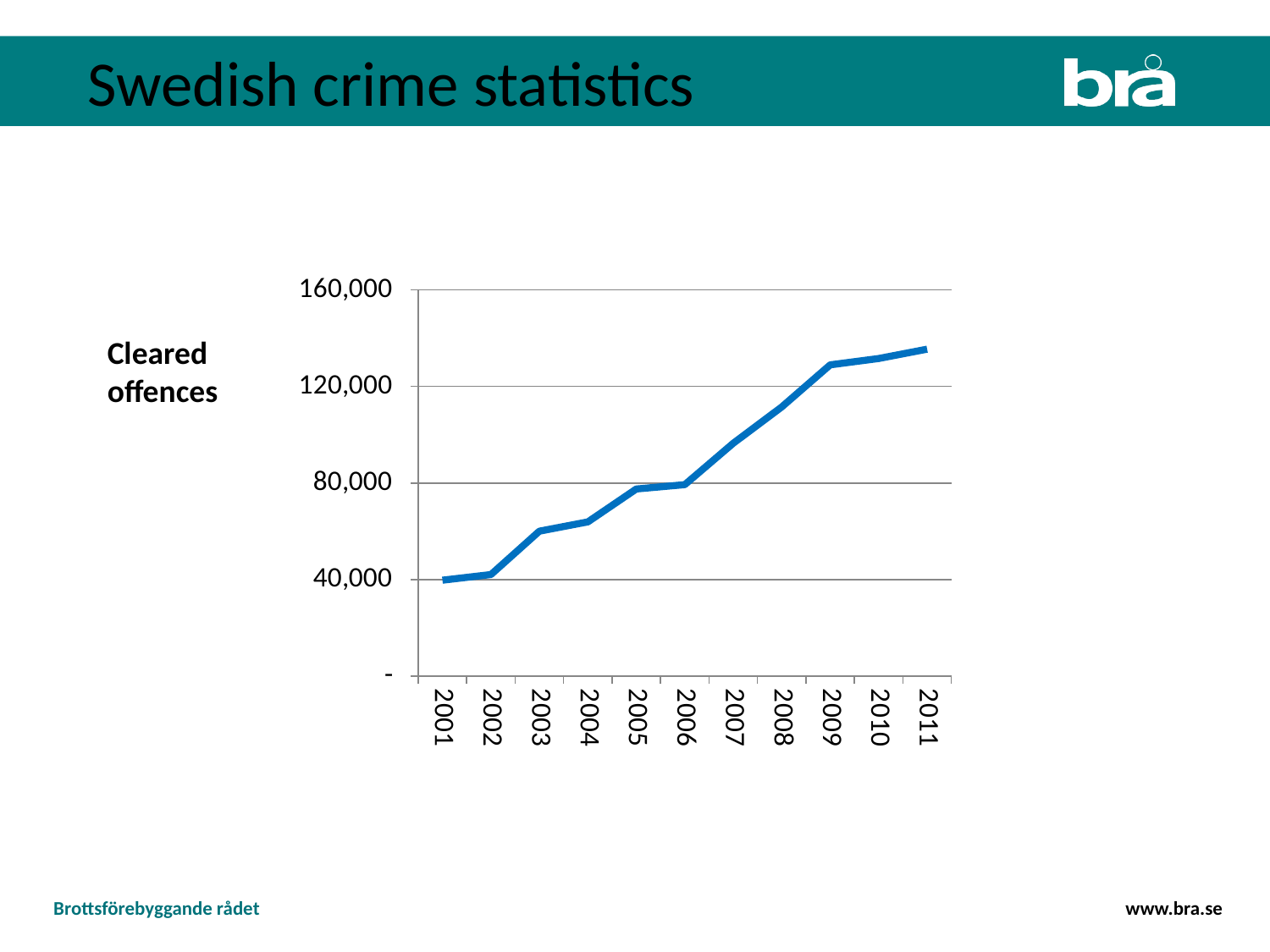
Which year has the larger value, 2006 or 2009? 2009 Which year has the lowest number of cleared offences? 2001 Is the value for 2003 greater or less than 80,000? less Is the value for 2011 greater or less than 160,000? less How many years are plotted along the x axis of the chart? 11 What quantity does the chart plot, according to the label to the left of the chart? Cleared offences Which year has the highest number of cleared offences? 2011 Is the value for 2007 greater or less than 80,000? greater Do the values for cleared offences rise or fall from 2001 to 2011? rise What kind of chart is shown on the slide? line chart